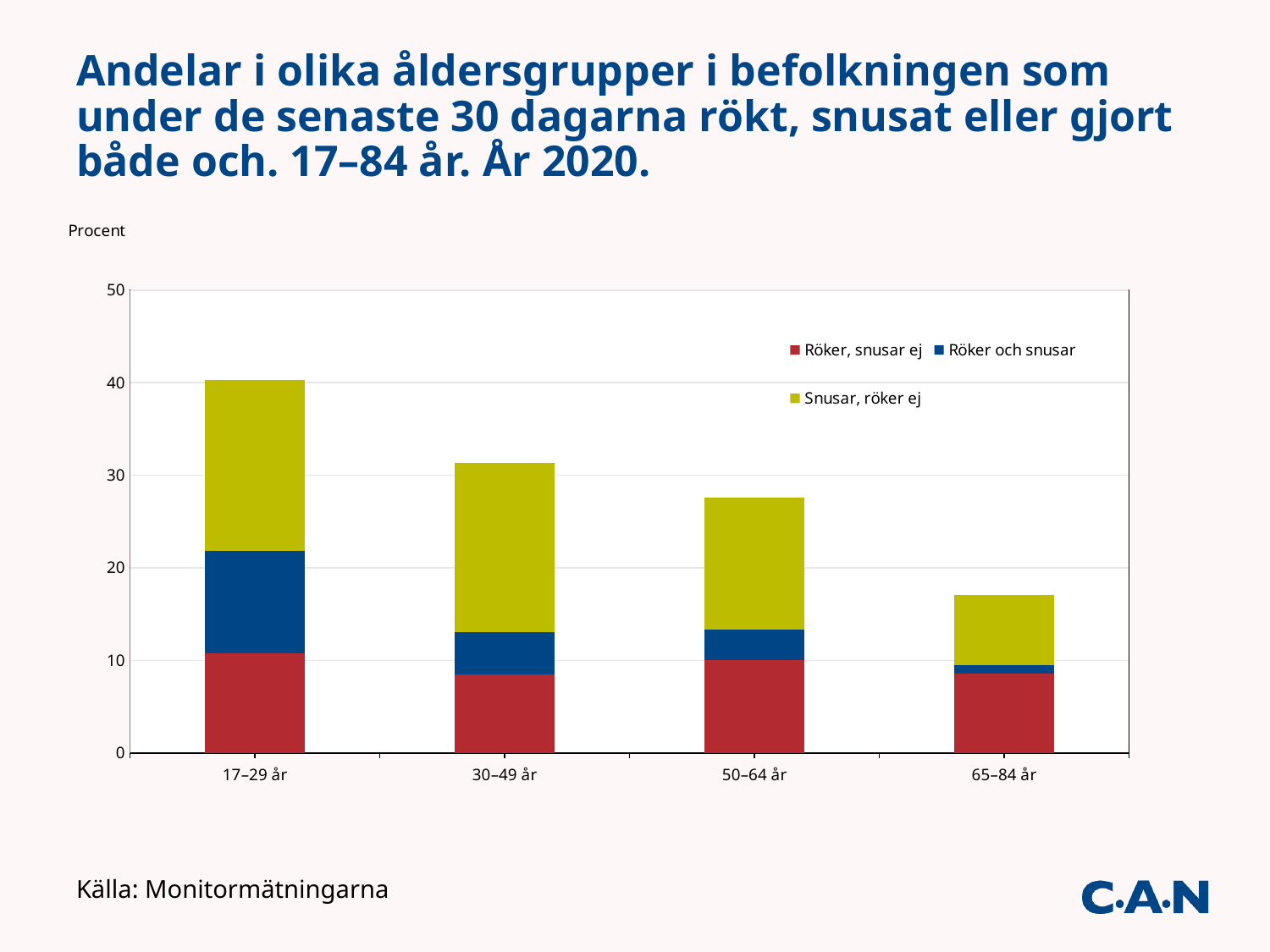
Is the total value for 17–29 år greater or less than 30? greater How many age groups are shown on the x axis? 4 Do the total bar heights rise or fall as age increases along the x axis? Fall Which total bar is larger, 30–49 år or 50–64 år? 30–49 år How many series does the legend list? 3 Which age group has the highest total bar? 17–29 år What label is shown on the y axis of the chart? Procent Is the total value for 50–64 år greater or less than 30? less Which age group has the largest 'Röker och snusar' segment? 17–29 år What kind of chart is shown on the slide? Stacked bar chart Is the total value for 65–84 år greater or less than 20? less Which age group has the lowest total bar? 65–84 år